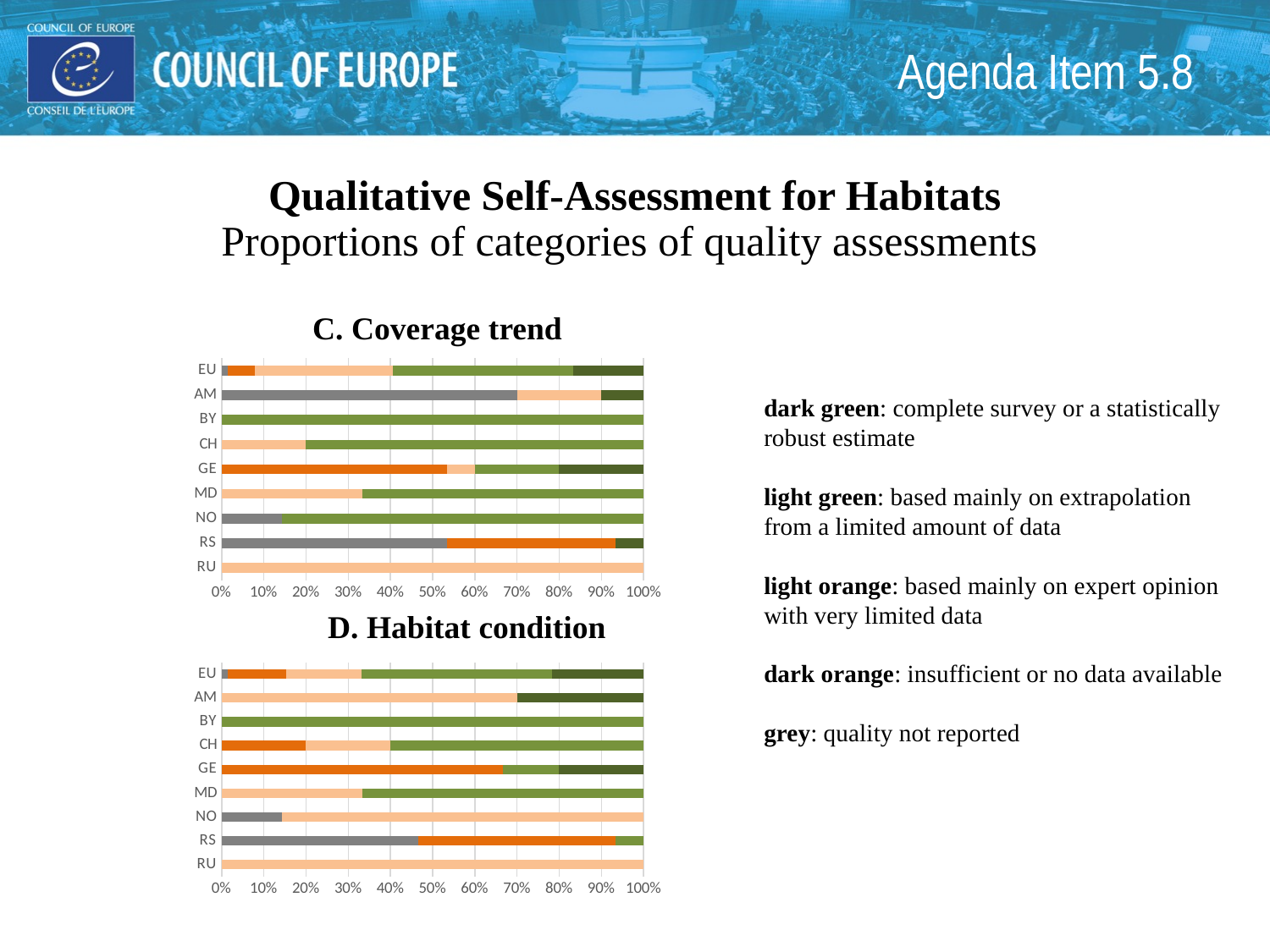
In the "D. Habitat condition" chart, is the grey segment for NO greater or less than 20%? less In the "D. Habitat condition" chart, which category's bar is entirely light orange? RU What is the highest value shown on the x axis of the "C. Coverage trend" chart? 100% In the "C. Coverage trend" chart, which category's bar is entirely light green? BY In the "C. Coverage trend" chart, which has the larger grey segment, AM or NO? AM What kind of chart is "C. Coverage trend"? Stacked bar chart In the "D. Habitat condition" chart, is the grey segment for RS greater or less than 40%? greater How many categories are shown on the y axis of the "D. Habitat condition" chart? 9 In the "C. Coverage trend" chart, is the dark orange segment for GE greater or less than 40%? greater